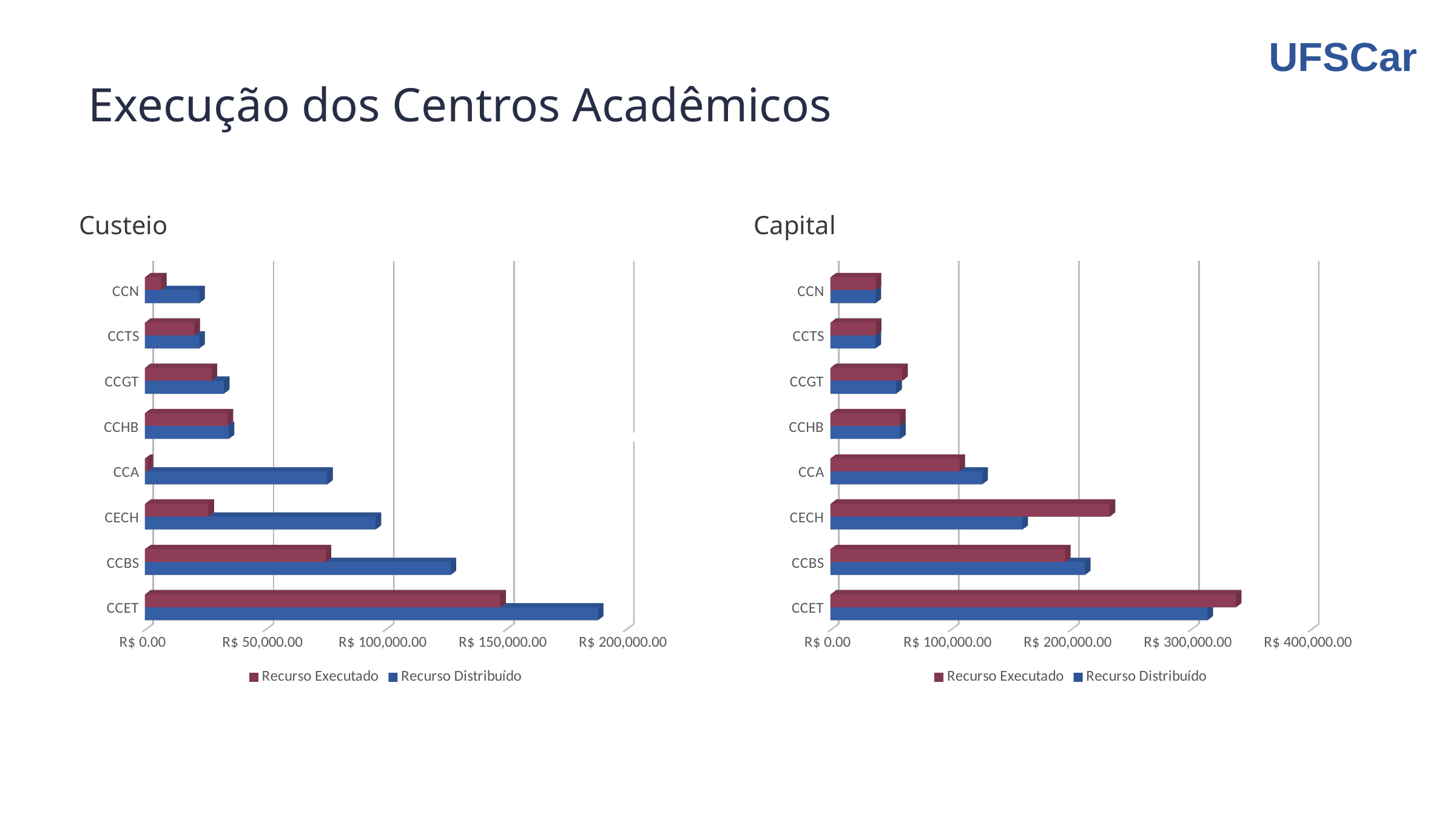
In the Custeio chart, which centre has the lowest Recurso Executado? CCA In the Custeio chart, is the Recurso Distribuído for CCA greater or less than R$ 50,000.00? greater In the Custeio chart, for CECH, which is larger: Recurso Executado or Recurso Distribuído? Recurso Distribuído How many academic centres are listed on the Capital chart? 8 How many series does the legend of the Custeio chart list? 2 In the Capital chart, is the Recurso Executado for CCN greater or less than R$ 100,000.00? less In the Capital chart, which centre has the highest Recurso Executado? CCET In the Custeio chart, is the Recurso Distribuído for CCET greater or less than R$ 150,000.00? greater What kind of chart is the Custeio chart? bar chart In the Capital chart, for CECH, which is larger: Recurso Executado or Recurso Distribuído? Recurso Executado In the Custeio chart, which centre has the highest Recurso Distribuído? CCET